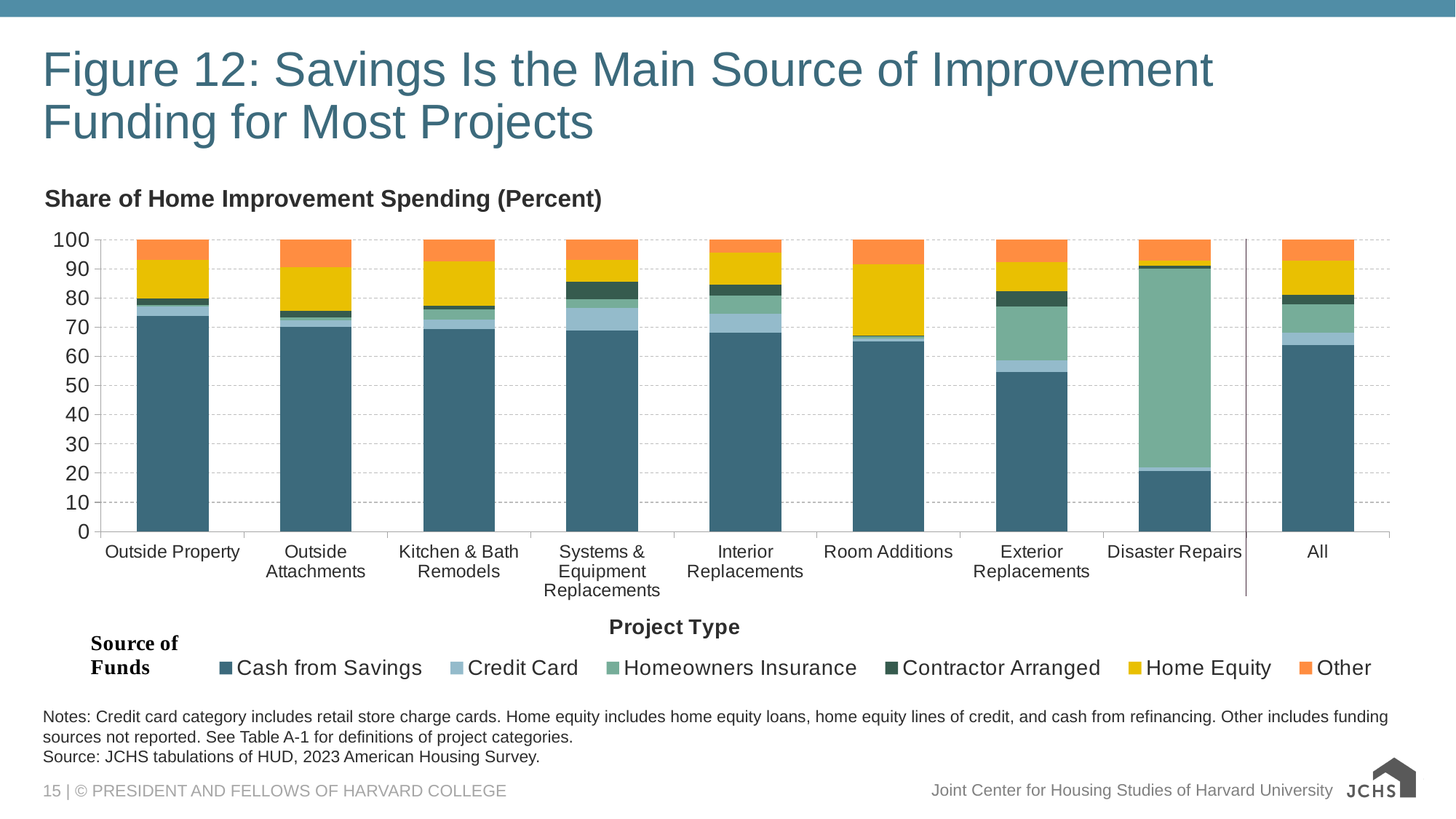
Which project type has the largest share of spending funded by Homeowners Insurance? Disaster Repairs Is the Cash from Savings share for Exterior Replacements greater or less than 50? greater How many project types (categories) are shown along the x axis? 9 What is the title of the x axis? Project Type Which has a larger Cash from Savings share: Outside Property or Disaster Repairs? Outside Property Is the Cash from Savings share for Disaster Repairs greater or less than 30? less Which project type has the smallest share of spending funded by Cash from Savings? Disaster Repairs How many sources of funds does the legend list? 6 What is the total height of each stacked bar on the percent axis? 100 Is the Cash from Savings share for All projects greater or less than 60? greater What kind of chart is shown on the slide? Stacked bar chart Which project type has the largest share of spending funded by Home Equity? Room Additions